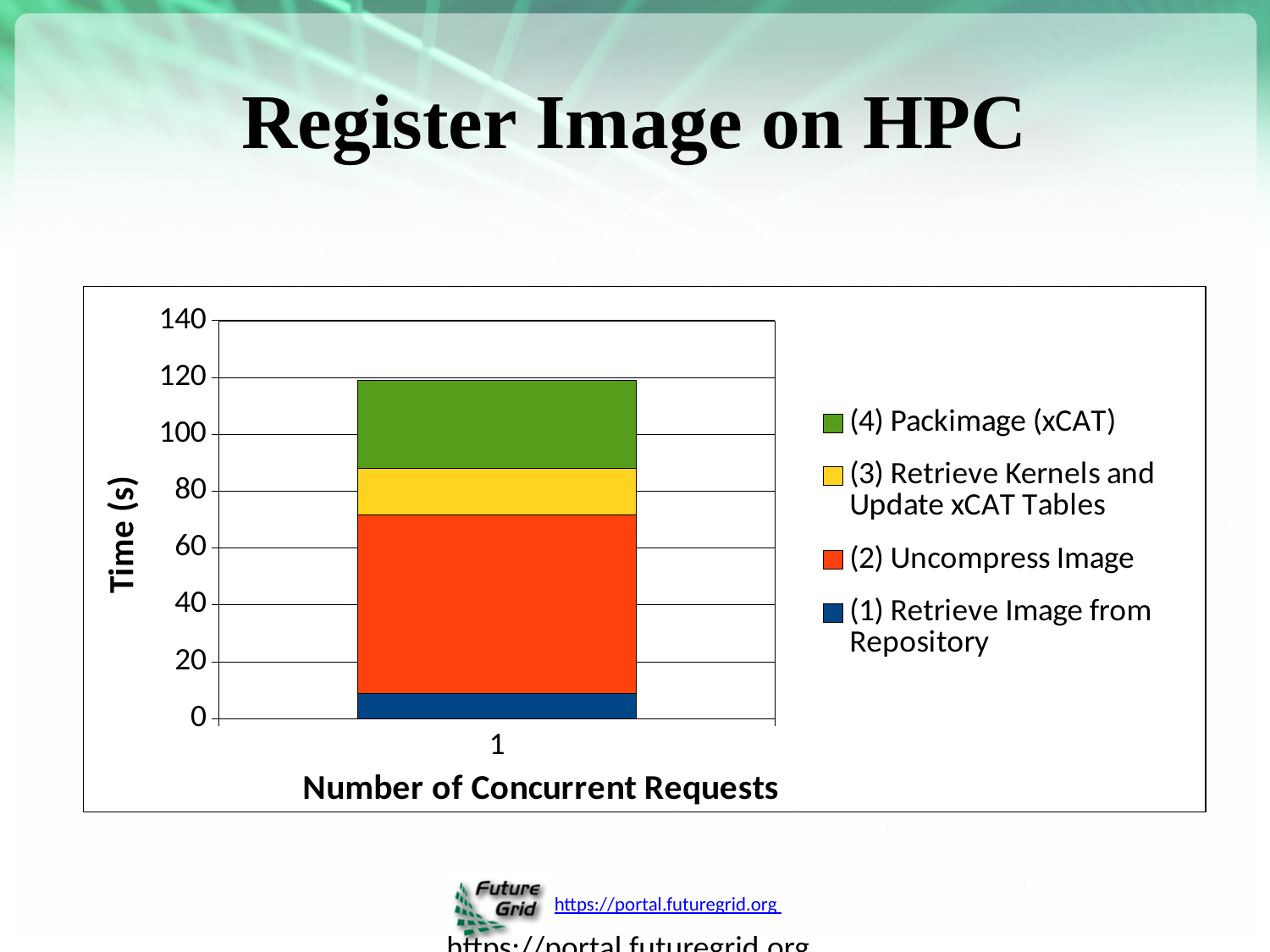
What is the title of the y axis? Time (s) How many series does the legend list? 4 What kind of chart is shown on the slide? Stacked bar chart Which segment is larger in the stacked bar: (2) Uncompress Image or (4) Packimage (xCAT)? (2) Uncompress Image Is the time for (2) Uncompress Image greater or less than 40? greater Which series contributes the largest segment to the stacked bar? (2) Uncompress Image Is the total height of the stacked bar for 1 concurrent request greater or less than 100? greater Which series contributes the smallest segment to the stacked bar? (1) Retrieve Image from Repository What is the category label shown on the x axis? 1 How many categories are plotted on the x axis? 1 Is the time for (1) Retrieve Image from Repository greater or less than 20? less What is the title of the x axis? Number of Concurrent Requests